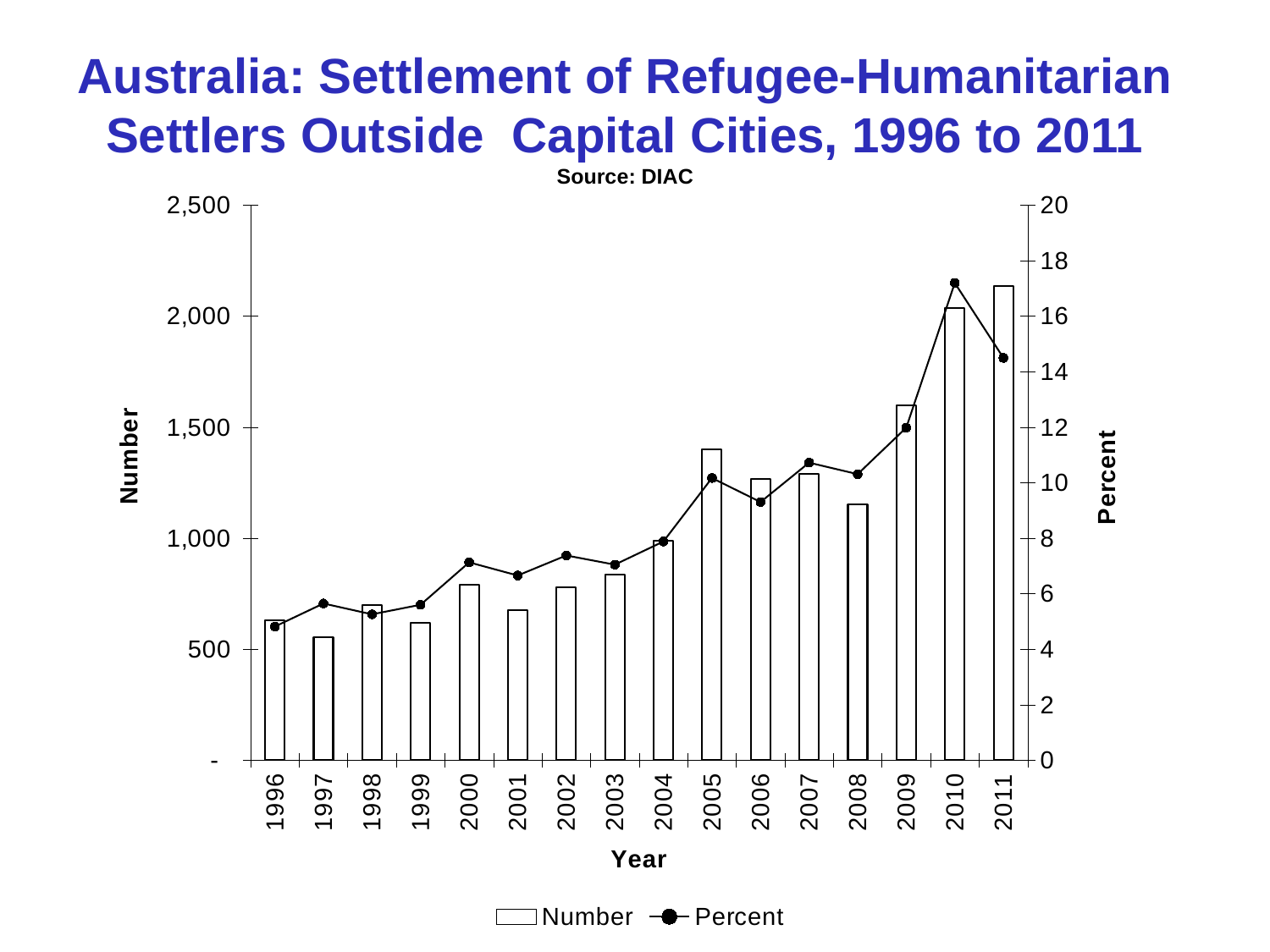
How many series does the legend list? 2 What kind of chart is shown on the slide? A combined bar and line chart Which year has the lowest Percent value? 1996 Is the Percent value for 2010 greater or less than 16? greater Which year has the highest Number bar? 2011 Which year has the lowest Number bar? 1997 Is the Number value for 2005 greater or less than 1,000? greater Which year has the highest Percent value? 2010 Which year has the larger Percent value, 2010 or 2011? 2010 Overall, do the Number values rise or fall from 1996 to 2011? rise Is the Percent value for 1996 greater or less than 6? less How many years are shown on the x axis? 16